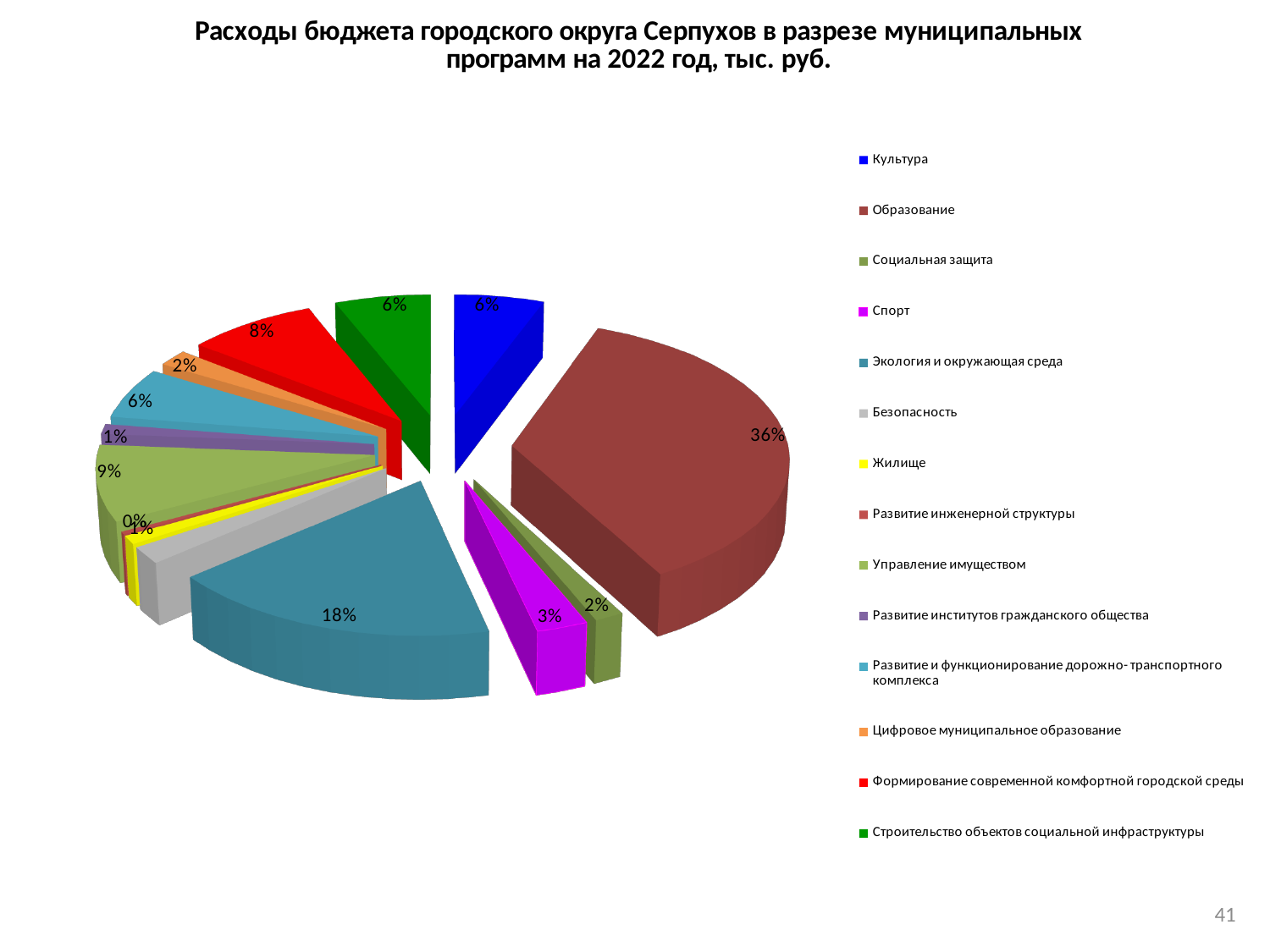
What share of the budget expenses goes to Управление имуществом? 9% How many categories does the legend of the pie chart list? 14 What year do the budget expenses in the chart title refer to? 2022 What share of the budget expenses goes to Образование? 36% What share of the budget expenses goes to Экология и окружающая среда? 18% What kind of chart is shown on the slide? Pie chart Which municipal program has the largest share of the budget expenses? Образование What share of the budget expenses goes to Спорт? 3% Which has the larger share: Управление имуществом or Формирование современной комфортной городской среды? Управление имуществом By how many percentage points does the share of Образование exceed the share of Экология и окружающая среда? 18 percentage points What share of the budget expenses goes to Культура? 6% What share of the budget expenses goes to Формирование современной комфортной городской среды? 8%